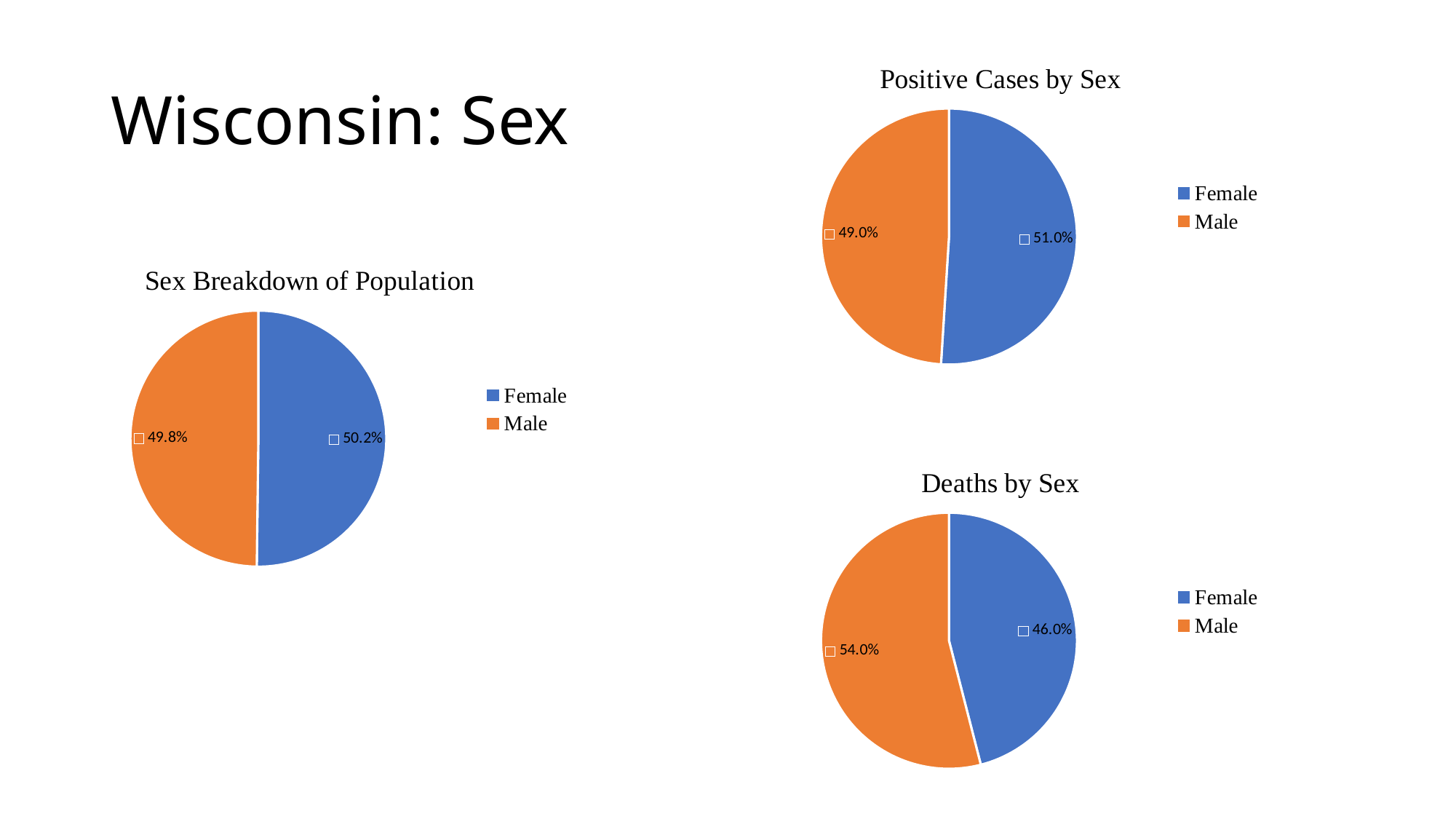
How many categories does the 'Sex Breakdown of Population' chart show? 2 In the 'Deaths by Sex' chart, what is the value for Female? 46.0% In the 'Sex Breakdown of Population' chart, what share of the pie is Male? 49.8% What kind of chart is 'Deaths by Sex'? Pie chart In the 'Sex Breakdown of Population' chart, what share of the pie is Female? 50.2% In the 'Positive Cases by Sex' chart, what colour is the Male slice? Orange In the 'Positive Cases by Sex' chart, what is the value for Female? 51.0% In the 'Positive Cases by Sex' chart, what is the difference between the Female and Male shares? 2.0% In the 'Positive Cases by Sex' chart, what is the value for Male? 49.0% In the 'Deaths by Sex' chart, which category has the largest slice? Male In the 'Deaths by Sex' chart, what is the difference between the Male and Female shares? 8.0% In the 'Deaths by Sex' chart, what is the value for Male? 54.0%